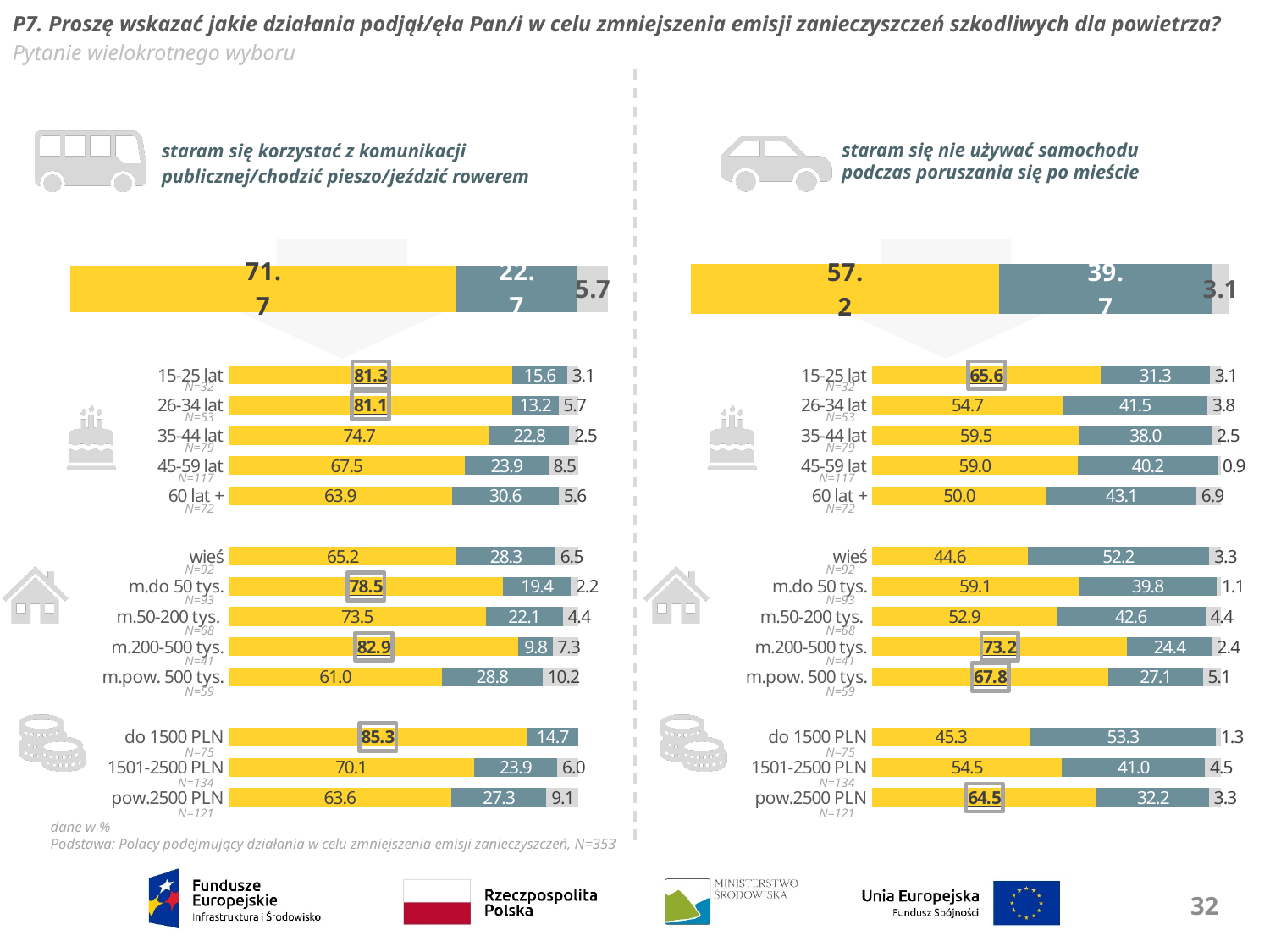
In the right chart, for wieś, which is larger: the yellow segment or the grey-blue segment? the grey-blue segment (52.2) In the left chart, what is the difference between the yellow values for 15-25 lat and 60 lat +? 17.4 In the left chart, do the yellow values rise or fall going from 15-25 lat down to 60 lat +? fall In the left chart, which category has the highest yellow value? do 1500 PLN What kind of chart is used on this slide? stacked horizontal bar chart In the right chart, what is the total of the stacked bar for 15-25 lat (65.6 + 31.3 + 3.1)? 100.0 In the right chart, what is the grey-blue (middle) value for wieś? 52.2 In the left chart, what is the value of the large yellow segment in the overall summary bar at the top? 71.7 In the left chart (staram się korzystać z komunikacji publicznej), what is the yellow value for the 15-25 lat group? 81.3 In the right chart (staram się nie używać samochodu), what is the yellow value for m.200-500 tys.? 73.2 In the right chart, which category has the lowest yellow value? wieś How many categories (rows) are plotted in the left chart below the summary bar? 13